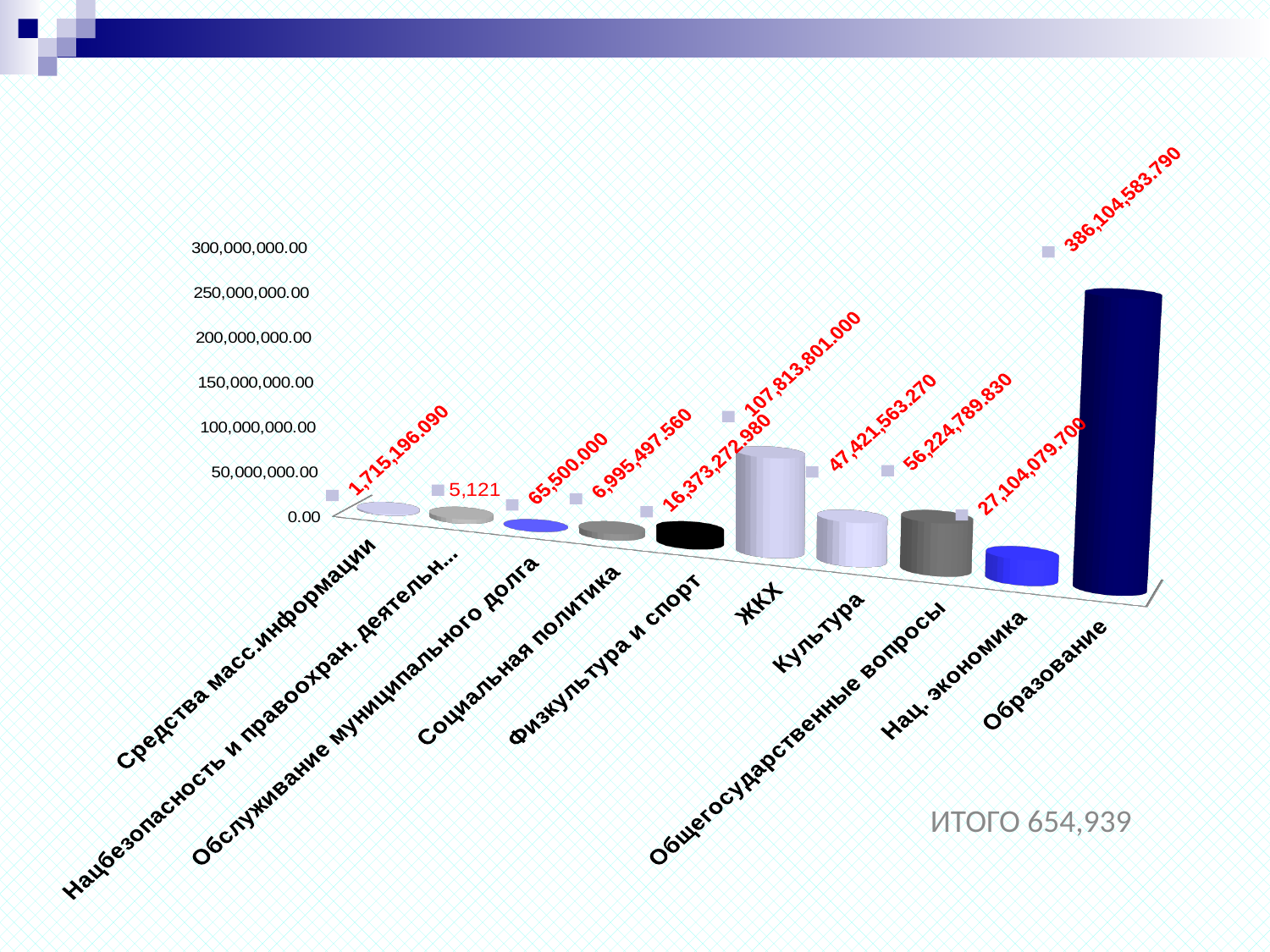
What is the value for Социальная политика? 6,995,497.560 Which is larger, the value for Культура or the value for Общегосударственные вопросы? Общегосударственные вопросы What kind of chart is shown on the slide? bar chart Is the value for ЖКХ greater or less than 150,000,000.00? less Which category has the lowest value? Обслуживание муниципального долга What is the value for Культура? 47,421,563.270 What is the value for Нац. экономика? 27,104,079.700 What is the difference between the values for ЖКХ and Общегосударственные вопросы? 51,589,011.170 How many categories are shown on the x axis? 10 What is the value for Образование? 386,104,583.790 Which category has the highest value? Образование What is the value for ЖКХ? 107,813,801.000